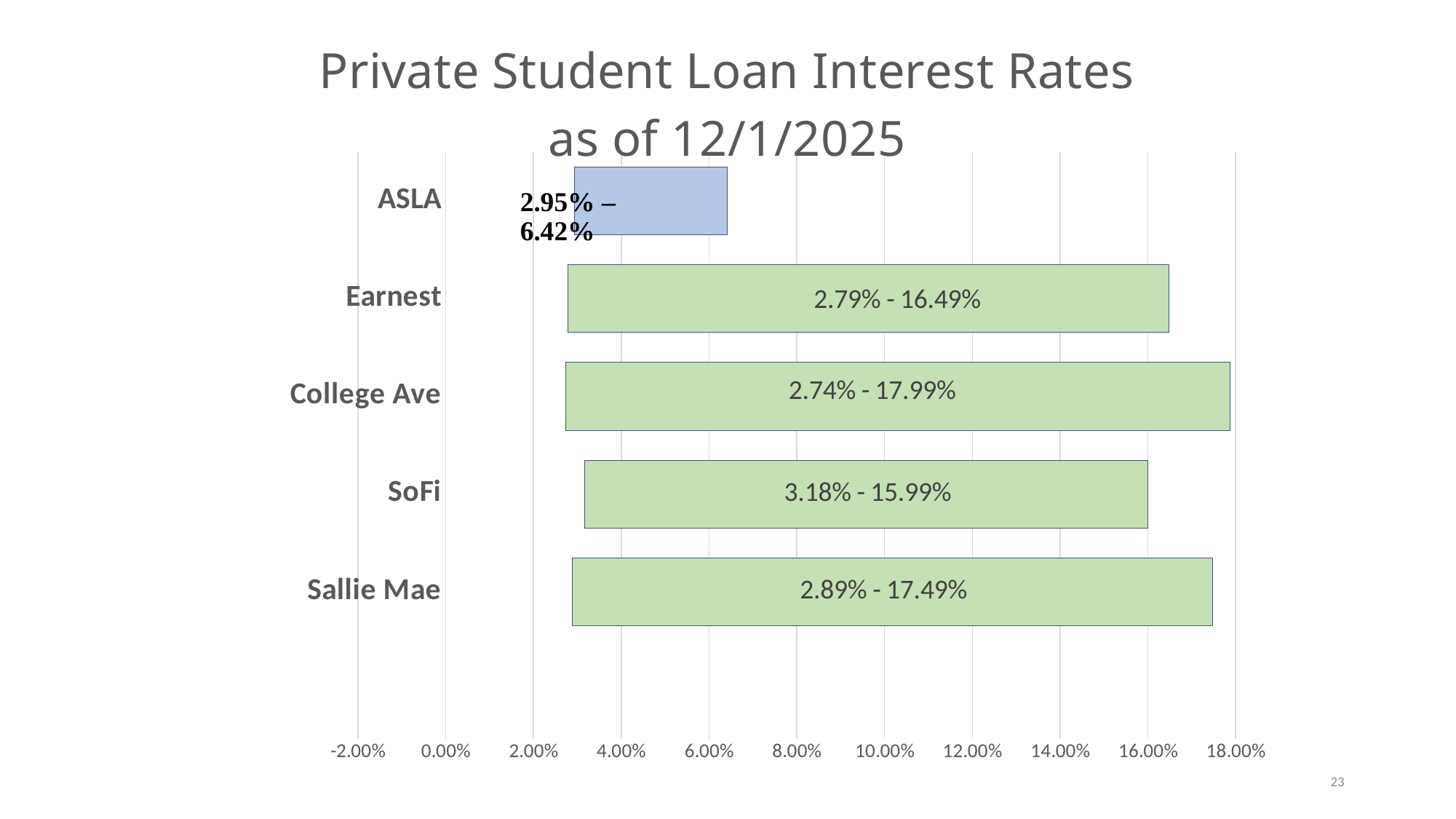
Which lender has the highest maximum interest rate? College Ave How many lenders are shown in the chart? 5 What interest rate range is shown for ASLA? 2.95% – 6.42% What interest rate range is shown for Earnest? 2.79% - 16.49% Which lender has the highest minimum interest rate? SoFi Which lender has the lowest maximum interest rate? ASLA What interest rate range is shown for Sallie Mae? 2.89% - 17.49% Which lender has a higher maximum interest rate, Earnest or Sallie Mae? Sallie Mae What is the difference between the maximum rates of College Ave and SoFi? 2.00% Is the upper end of the ASLA bar greater or less than 8.00%? less What is the title of the chart? Private Student Loan Interest Rates as of 12/1/2025 What type of chart is shown on the slide? Bar chart